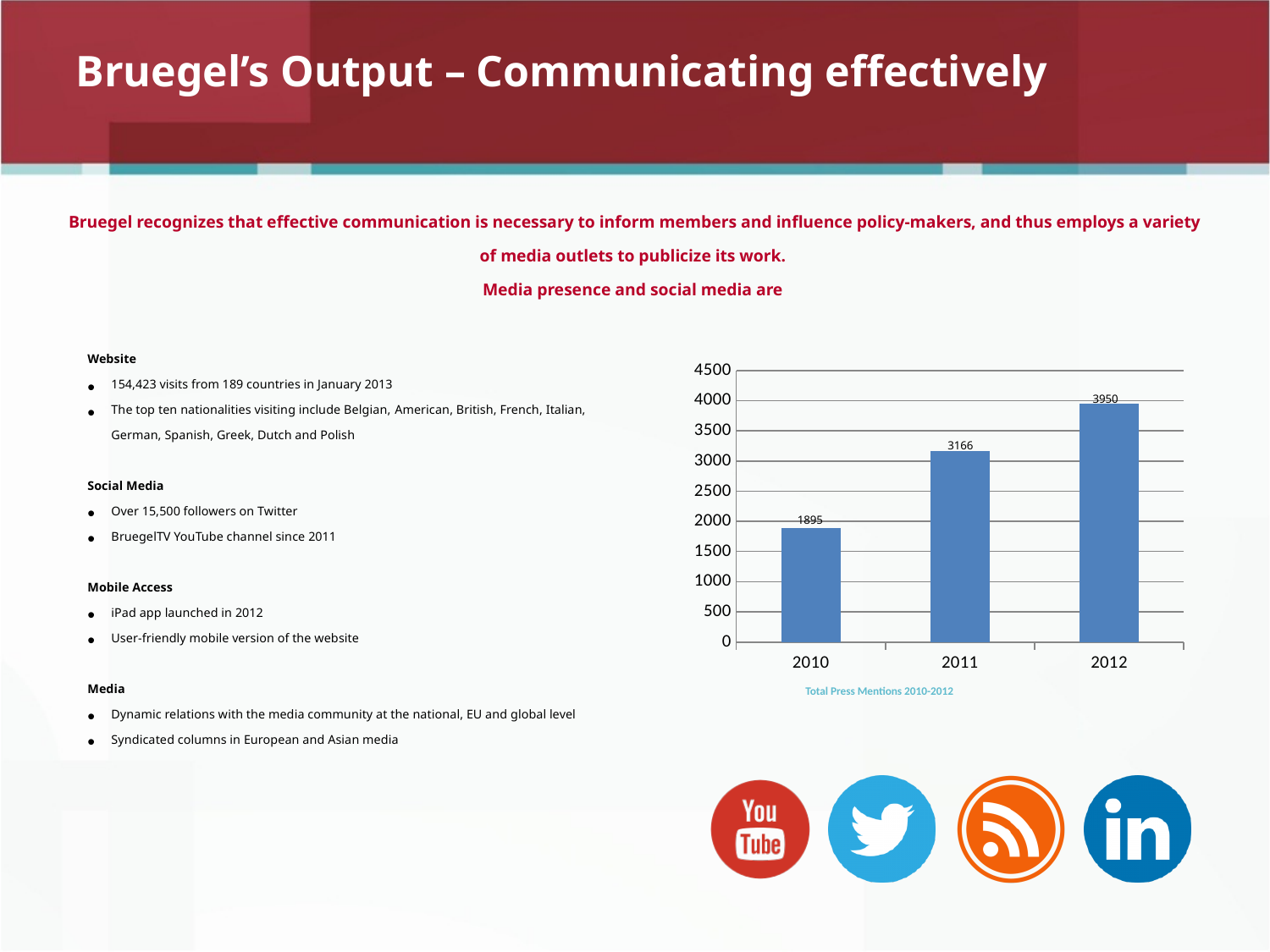
What is the difference in press mentions between 2012 and 2011? 784 What kind of chart is used to show Total Press Mentions 2010-2012? Bar chart Is the value for 2012 greater or less than 3500? greater Which year has the lowest number of press mentions? 2010 How many years are shown in the Total Press Mentions chart? 3 What is the value for 2010 in the Total Press Mentions chart? 1895 Which year has the highest number of press mentions? 2012 Which year had more press mentions, 2010 or 2011? 2011 What is the difference in press mentions between 2011 and 2010? 1271 Do press mentions rise or fall from 2010 to 2012? Rise What is the value for 2011 in the Total Press Mentions chart? 3166 What is the value for 2012 in the Total Press Mentions chart? 3950